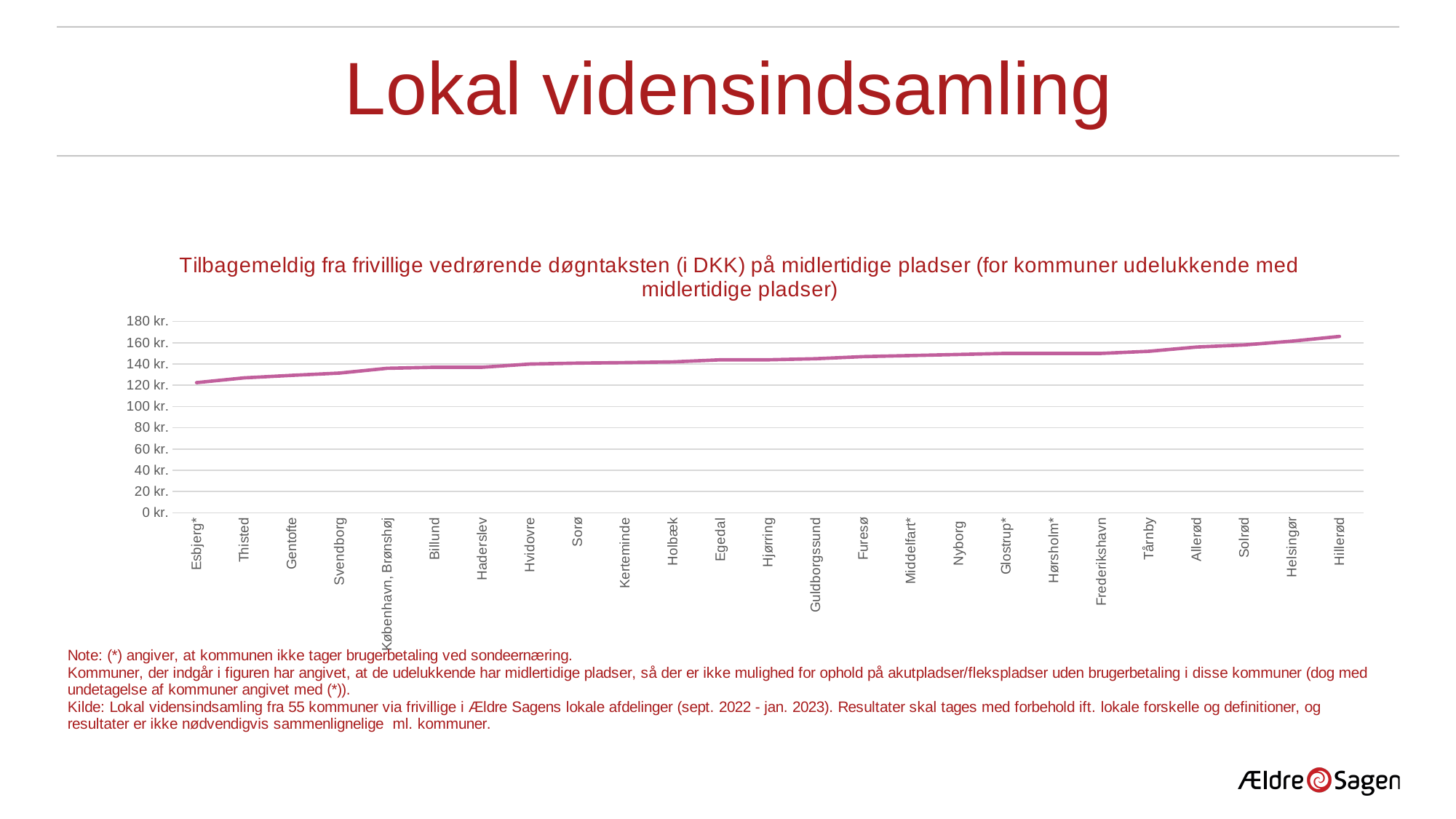
Is the value for Hillerød greater or less than 160 kr.? greater Which has the larger value, Hillerød or Esbjerg*? Hillerød Is the value for Frederikshavn greater or less than 140 kr.? greater Is the value for Esbjerg* greater or less than 140 kr.? less Which municipality has the highest value in the chart? Hillerød Do the values rise or fall moving from left to right along the x axis? rise What colour is the line in the chart? pink Which municipality has the lowest value in the chart? Esbjerg* How many municipalities are plotted along the x axis of the chart? 25 What is the highest tick value shown on the y axis of the chart? 180 kr. What kind of chart is shown on the slide? line chart